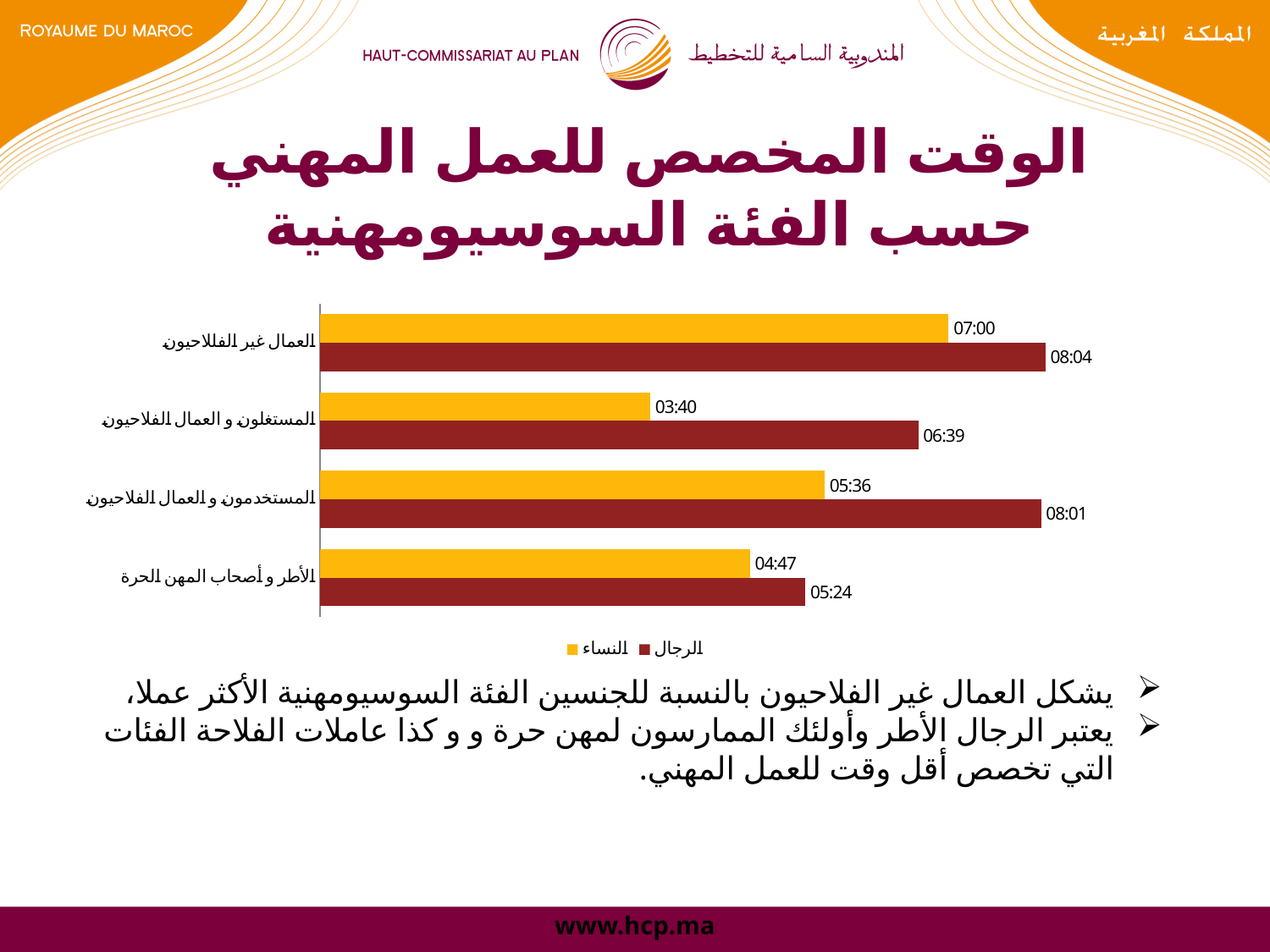
In the category المستغلون و العمال الفلاحيون, which is larger: the value for الرجال or for النساء? الرجال What is the value for النساء in the category المستغلون و العمال الفلاحيون? 03:40 Which category has the lowest value for الرجال? الأطر و أصحاب المهن الحرة What is the value for الرجال in the category المستخدمون و العمال الفلاحيون? 08:01 Which category has the lowest value for النساء? المستغلون و العمال الفلاحيون How many series does the legend list? 2 What kind of chart is shown on the slide? bar chart What are the two series named in the legend? الرجال and النساء Which category has the highest value for الرجال? العمال غير الفلاحيون How many socio-professional categories are shown on the chart? 4 What is the value for الرجال in the category العمال غير الفلاحيون? 08:04 What is the value for النساء in the category الأطر و أصحاب المهن الحرة? 04:47